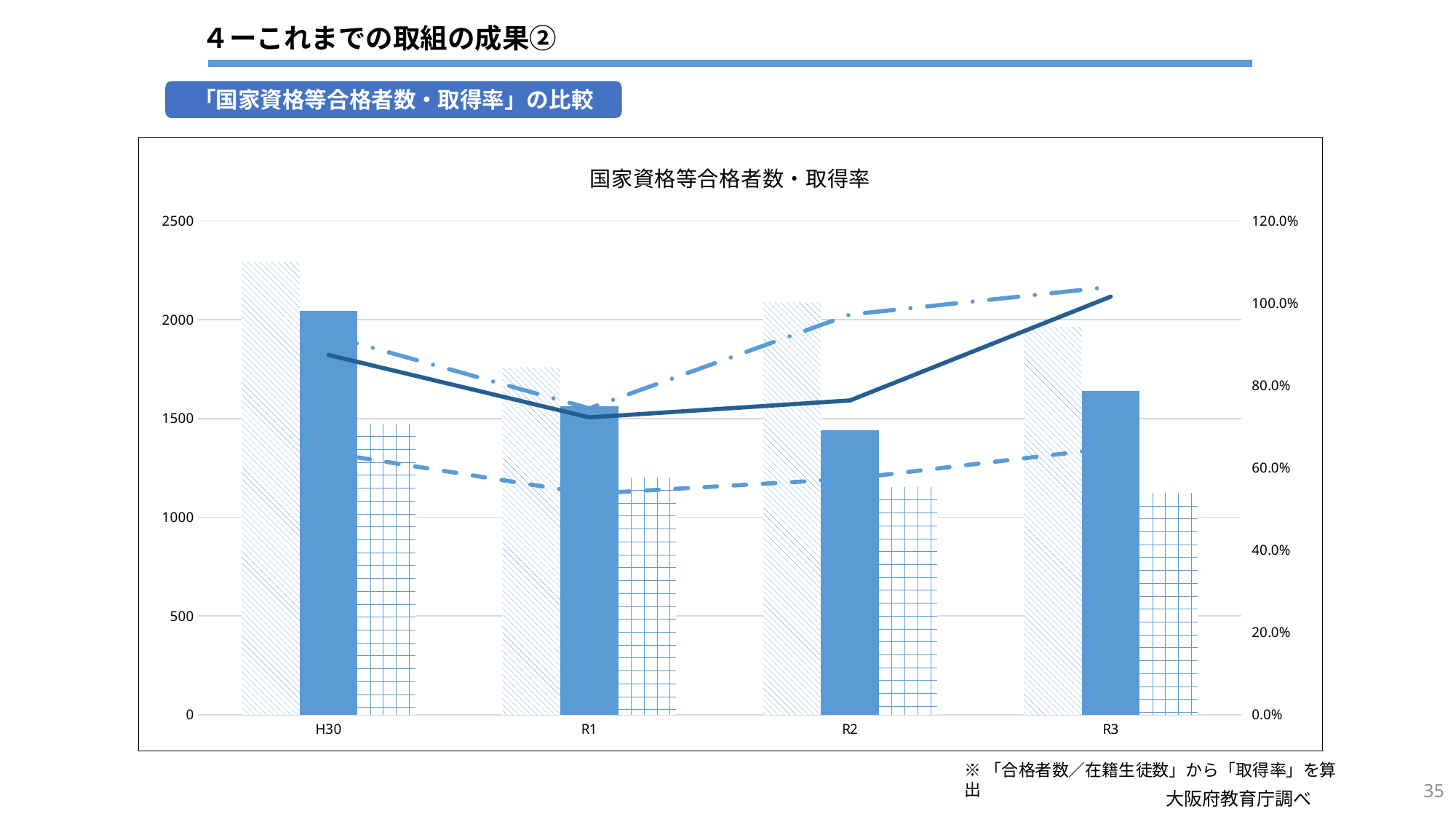
Is the value of the solid blue bar for H30 greater or less than 2000? greater What is the highest value shown on the right-hand axis of the chart? 120.0% Does the solid dark blue line rise or fall from R1 to R3? rise For which category is the solid blue bar the highest? H30 Is the value of the grid-patterned bar for R1 greater or less than 1000? greater How many categories are shown on the x axis of the chart? 4 Is the value of the solid blue bar for R2 greater or less than 1500? less Which is larger, the diagonal-hatched bar for H30 or the diagonal-hatched bar for R3? H30 What is the title of the chart? 国家資格等合格者数・取得率 For which category is the diagonal-hatched bar the lowest? R1 What kind of chart is shown on the slide? A combined bar and line chart For which category is the solid blue bar the lowest? R2